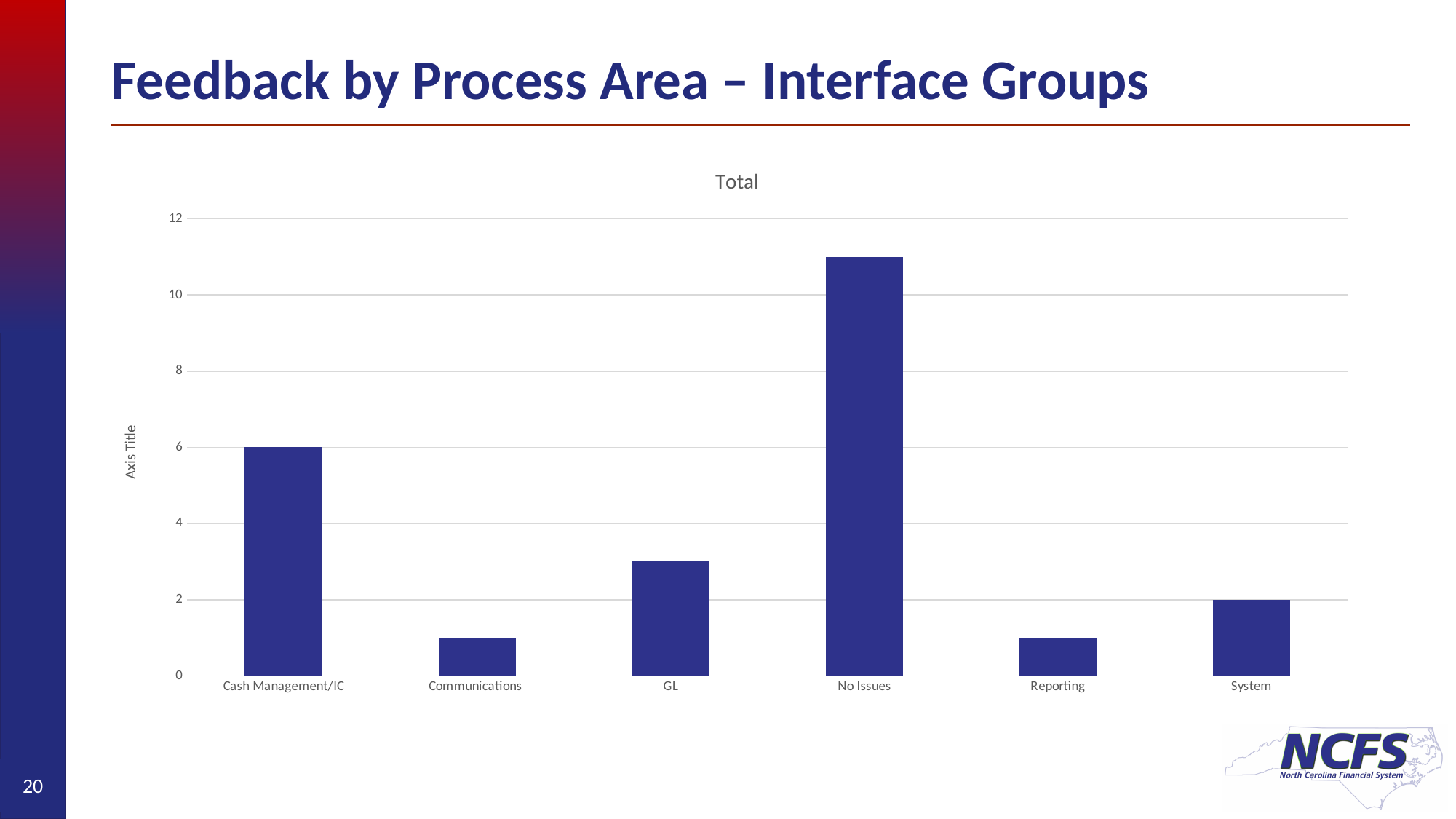
What is the value for Cash Management/IC? 6 Which is larger, the value for GL or the value for System? GL What label is shown on the vertical axis of the chart? Axis Title What is the value for System? 2 Is the value for GL greater or less than 4? less Is the value for Communications greater or less than 2? less How many categories are shown on the x axis of the chart? 6 What type of chart is shown on the slide? Bar chart What is the difference between the values for Cash Management/IC and System? 4 What is the title of the chart? Total Is the value for No Issues greater or less than 10? greater Which category has the highest value in the chart? No Issues